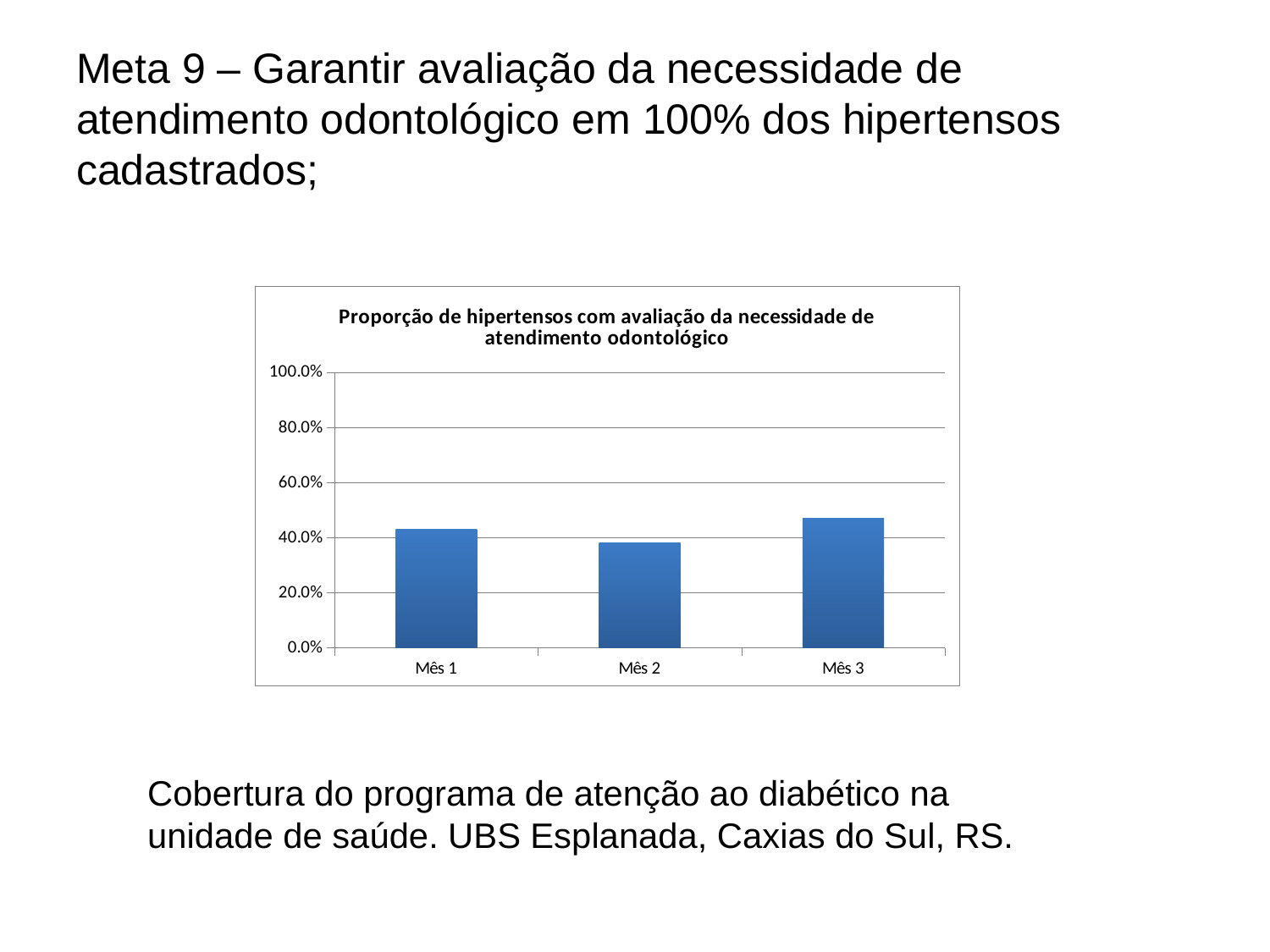
Is the value for Mês 1 greater or less than 40.0%? greater Which is larger, the value for Mês 3 or the value for Mês 2? Mês 3 What is the title of the chart? Proporção de hipertensos com avaliação da necessidade de atendimento odontológico Which month has the lowest proportion of hypertensive patients with dental care needs assessment? Mês 2 Is the value for Mês 3 greater or less than 40.0%? greater How many categories (months) are plotted on the x axis? 3 Which month has the highest proportion of hypertensive patients with dental care needs assessment? Mês 3 Is the value for Mês 2 greater or less than 20.0%? greater Do the values rise steadily from Mês 1 to Mês 3? No, they fall from Mês 1 to Mês 2 and then rise in Mês 3 Which is larger, the value for Mês 1 or the value for Mês 2? Mês 1 What kind of chart is shown on the slide? bar chart